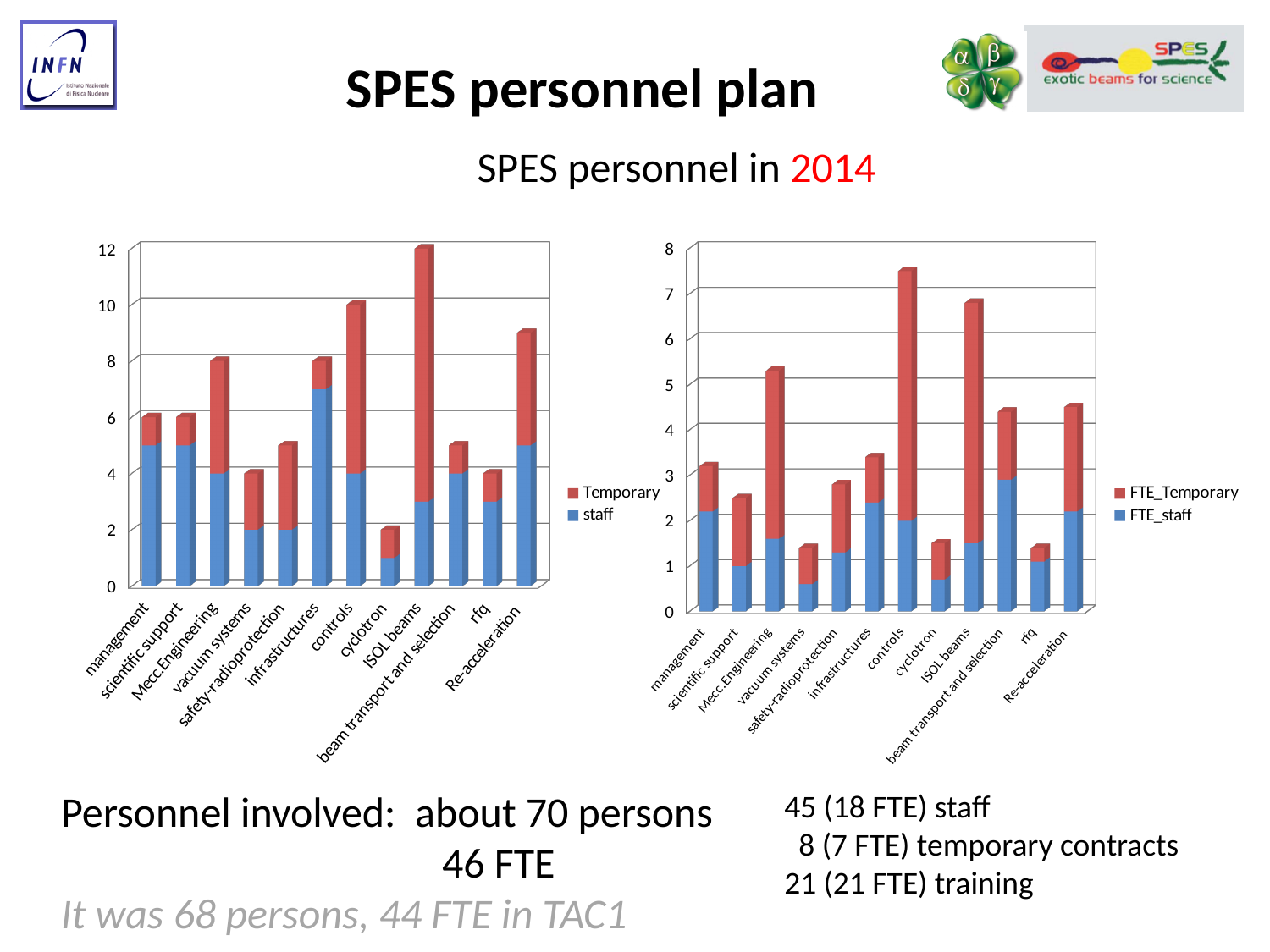
In the left chart, which category has the shortest stacked bar? cyclotron What kind of chart is the left chart on the slide? bar chart What are the two legend entries of the right chart? FTE_Temporary and FTE_staff In the left chart, is the total value for cyclotron greater or less than 4? less In the right chart, which stacked bar is taller: ISOL beams or Mecc.Engineering? ISOL beams In the right chart, which category has the tallest stacked bar? controls How many categories are shown on the x axis of the left chart? 12 In the right chart, is the total value for vacuum systems greater or less than 2? less In the left chart, which category has the tallest stacked bar? ISOL beams In the left chart, is the total value for ISOL beams greater or less than 10? greater How many series does the legend of the right chart list? 2